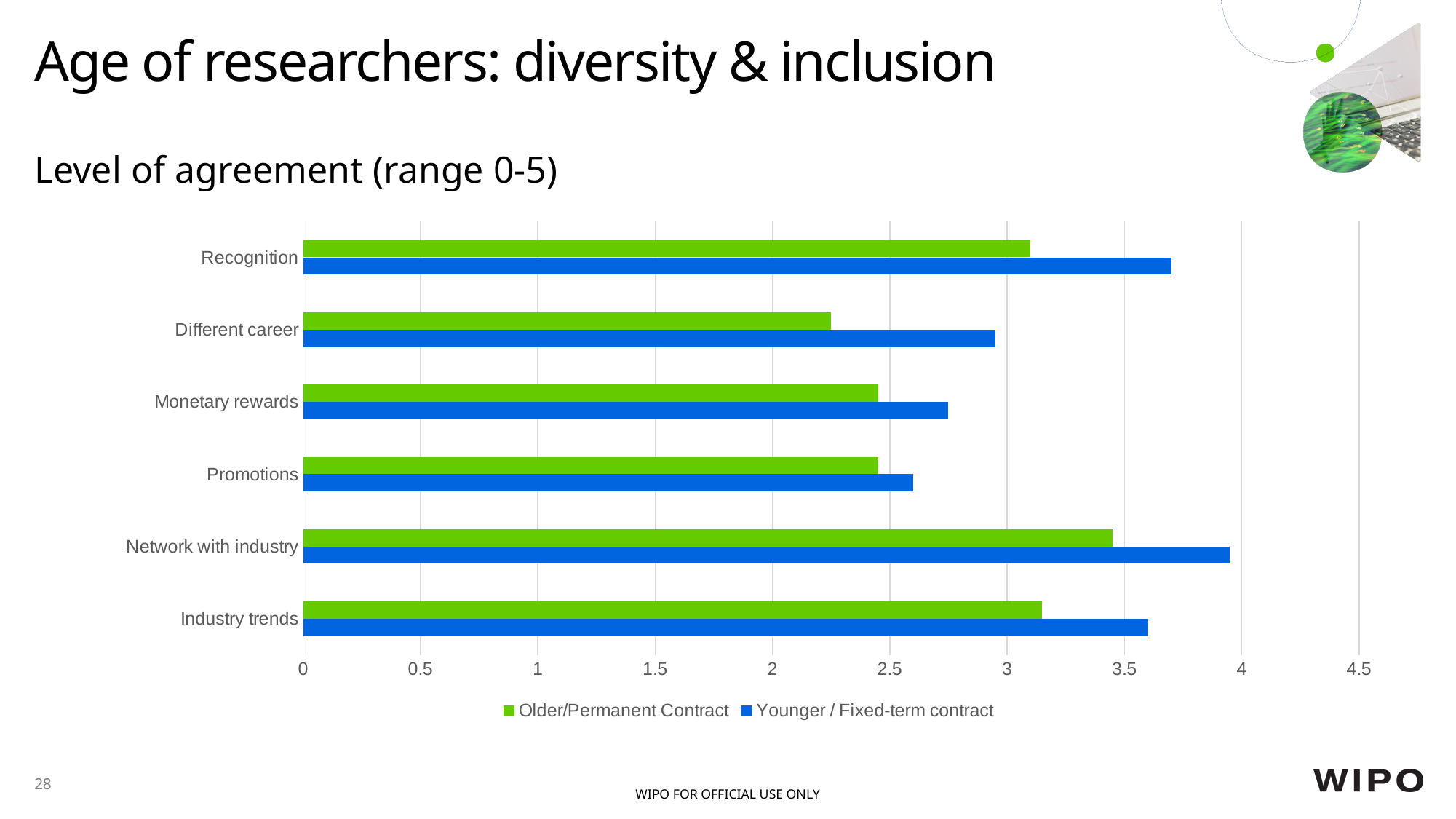
Which category has the highest value for the Older/Permanent Contract series? Network with industry What kind of chart is shown on the slide? Bar chart Which category has the lowest value for the Older/Permanent Contract series? Different career Is the Younger / Fixed-term contract value for Recognition greater or less than 3.5? greater Which colour represents the Older/Permanent Contract series in the legend? Green Is the Older/Permanent Contract value for Different career greater or less than 2.5? less How many categories are shown on the chart? 6 Which category has the highest value for the Younger / Fixed-term contract series? Network with industry For Different career, which series has the larger value: Older/Permanent Contract or Younger / Fixed-term contract? Younger / Fixed-term contract How many series does the legend list? 2 Is the Older/Permanent Contract value for Industry trends greater or less than 3? greater What is the highest value shown on the horizontal axis? 4.5